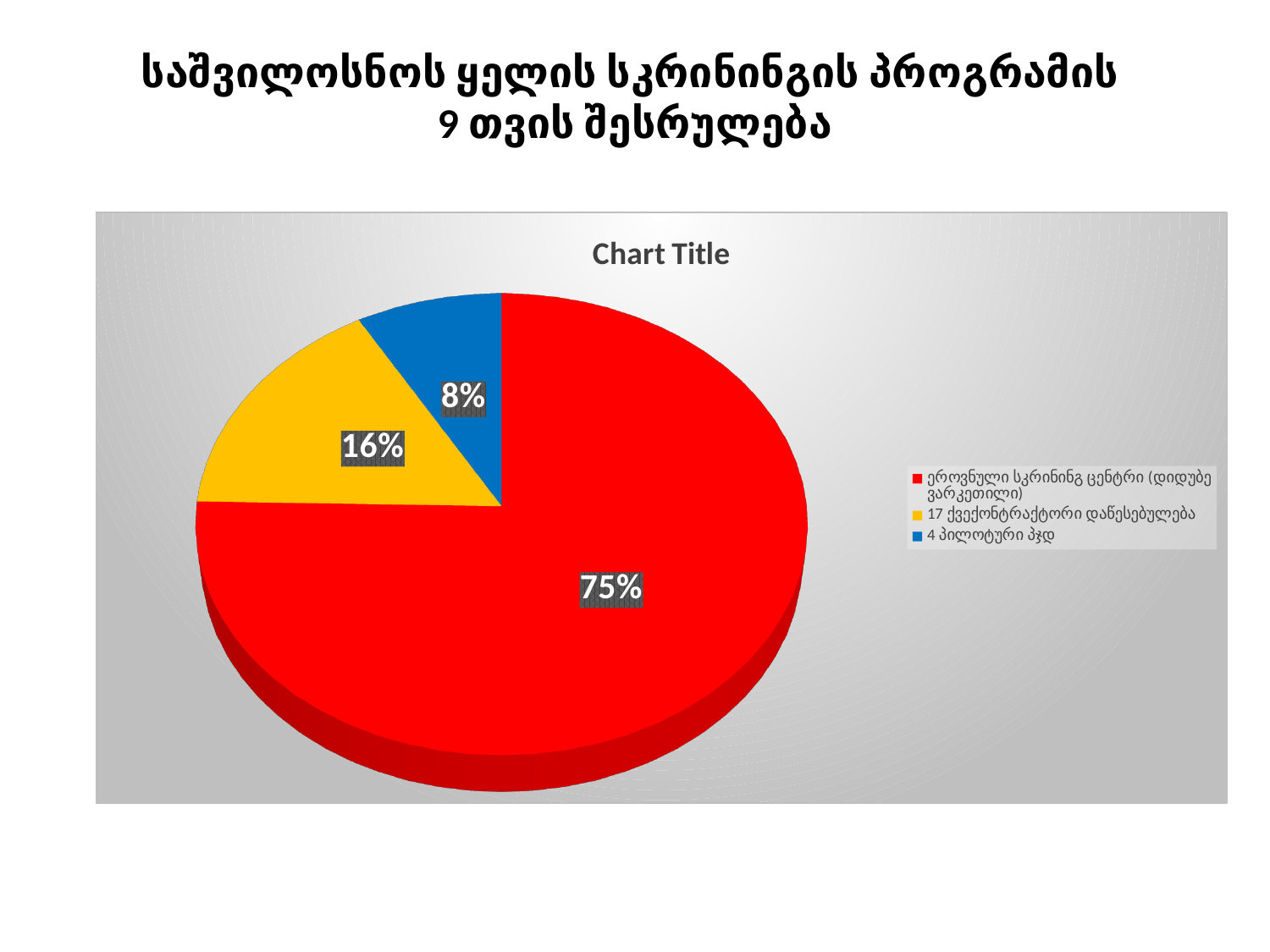
What share of the pie does the slice for 17 ქვეკონტრაქტორი დაწესებულება represent? 16% Which category has the smallest slice of the pie? 4 პილოტური პჯდ What colour is the slice for 4 პილოტური პჯდ? blue Which category has the largest slice of the pie? ეროვნული სკრინინგ ცენტრი (დიდუბე ვარკეთილი) What share of the pie does the slice for 4 პილოტური პჯდ represent? 8% What is the title shown above the pie chart? Chart Title What is the difference in percentage points between the slice for 17 ქვეკონტრაქტორი დაწესებულება and the slice for 4 პილოტური პჯდ? 8 percentage points What kind of chart is shown on the slide? pie chart What share of the pie does the slice for ეროვნული სკრინინგ ცენტრი (დიდუბე ვარკეთილი) represent? 75% What is the difference in percentage points between the slice for ეროვნული სკრინინგ ცენტრი (დიდუბე ვარკეთილი) and the slice for 17 ქვეკონტრაქტორი დაწესებულება? 59 percentage points How many slices does the pie chart have? 3 Which slice is larger: 17 ქვეკონტრაქტორი დაწესებულება or 4 პილოტური პჯდ? 17 ქვეკონტრაქტორი დაწესებულება